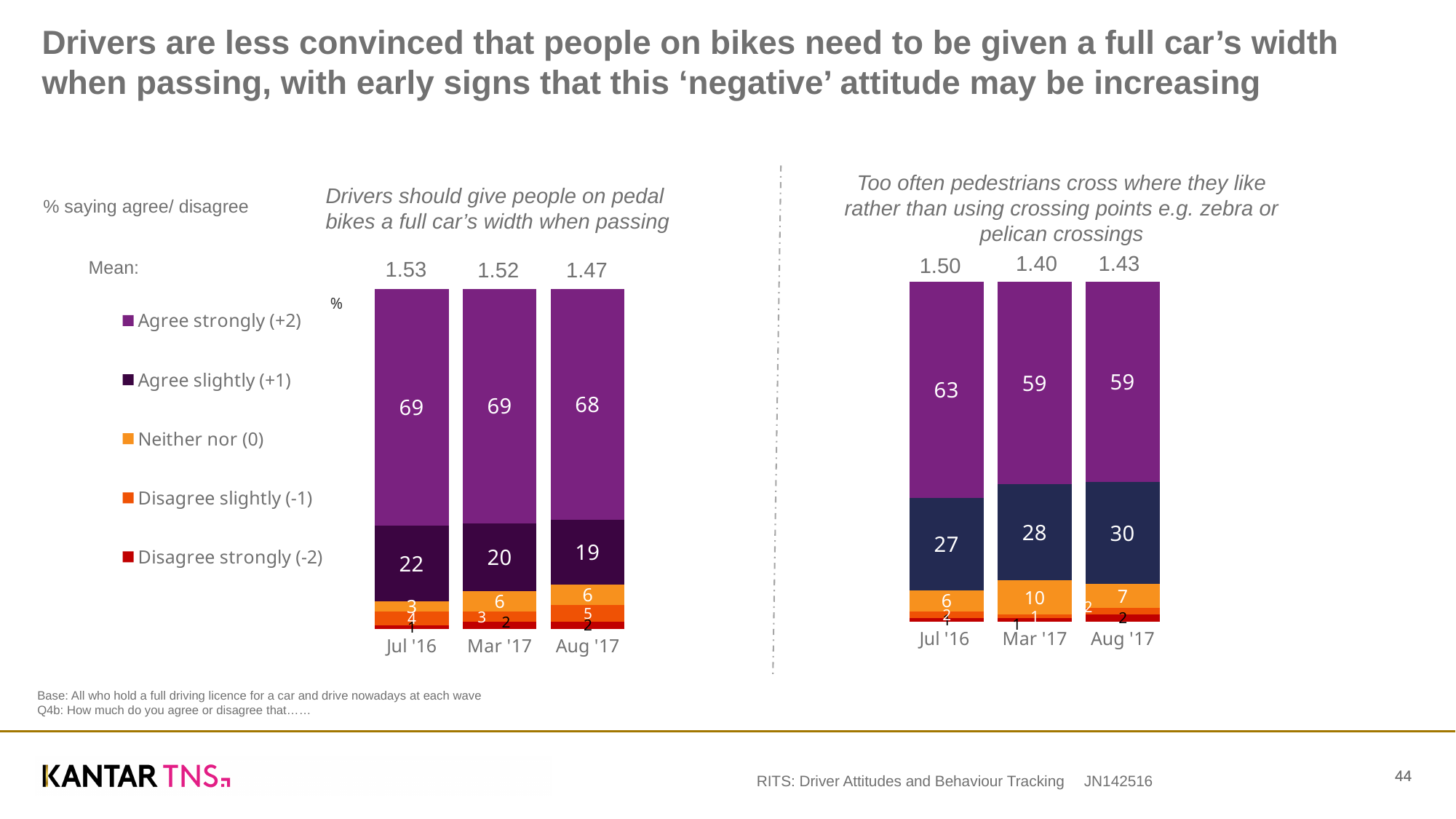
In the chart titled 'Too often pedestrians cross where they like rather than using crossing points', which wave has the lowest mean? Mar '17 What kind of chart is used on this slide? Stacked bar chart In the chart titled 'Too often pedestrians cross where they like rather than using crossing points', which wave has the highest 'Agree strongly' value? Jul '16 In the chart titled 'Drivers should give people on pedal bikes a full car's width when passing', what is the difference between the 'Agree slightly' values for Jul '16 and Aug '17? 3 How many series does the legend list? 5 In the chart titled 'Too often pedestrians cross where they like rather than using crossing points', what percentage agreed strongly in Mar '17? 59 In the chart titled 'Drivers should give people on pedal bikes a full car's width when passing', what percentage agreed slightly in Aug '17? 19 In the chart titled 'Drivers should give people on pedal bikes a full car's width when passing', what is the mean shown for Aug '17? 1.47 In the chart titled 'Drivers should give people on pedal bikes a full car's width when passing', what percentage agreed strongly in Jul '16? 69 In the chart titled 'Too often pedestrians cross where they like rather than using crossing points', what percentage agreed slightly in Aug '17? 30 How many waves (categories) are shown on the x axis of the left chart? 3 In the chart titled 'Too often pedestrians cross where they like rather than using crossing points', is the 'Neither nor' value larger in Mar '17 or Aug '17? Mar '17